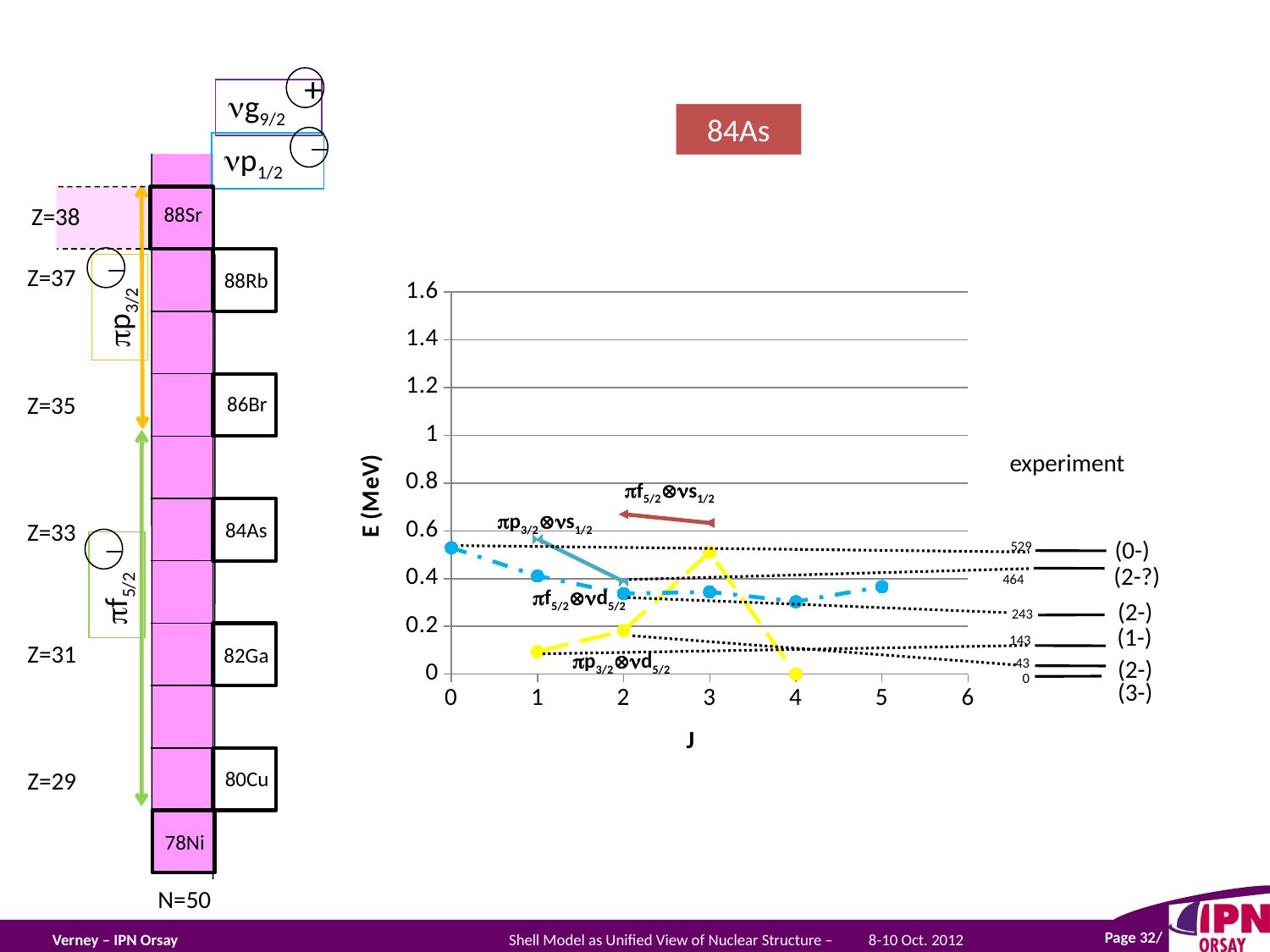
Is the value of the blue series at J=0 greater or less than 0.4? greater What is the label of the y axis of the chart? E (MeV) What is the label of the x axis of the chart? J What is the energy (in keV) of the highest experimental level shown on the right of the chart? 529 At which J does the yellow dashed series reach its lowest value? 4 Is the value of the yellow series at J=3 greater or less than 0.4? greater At which J does the yellow dashed series reach its highest value? 3 What kind of chart is shown on the slide? line chart Is the value of the yellow series at J=1 greater or less than 0.2? less What is the difference between the two highest experimental levels, 529 and 464? 65 Which is larger: the blue series value at J=0 or at J=4? J=0 How many data points does the blue dash-dot series have? 6